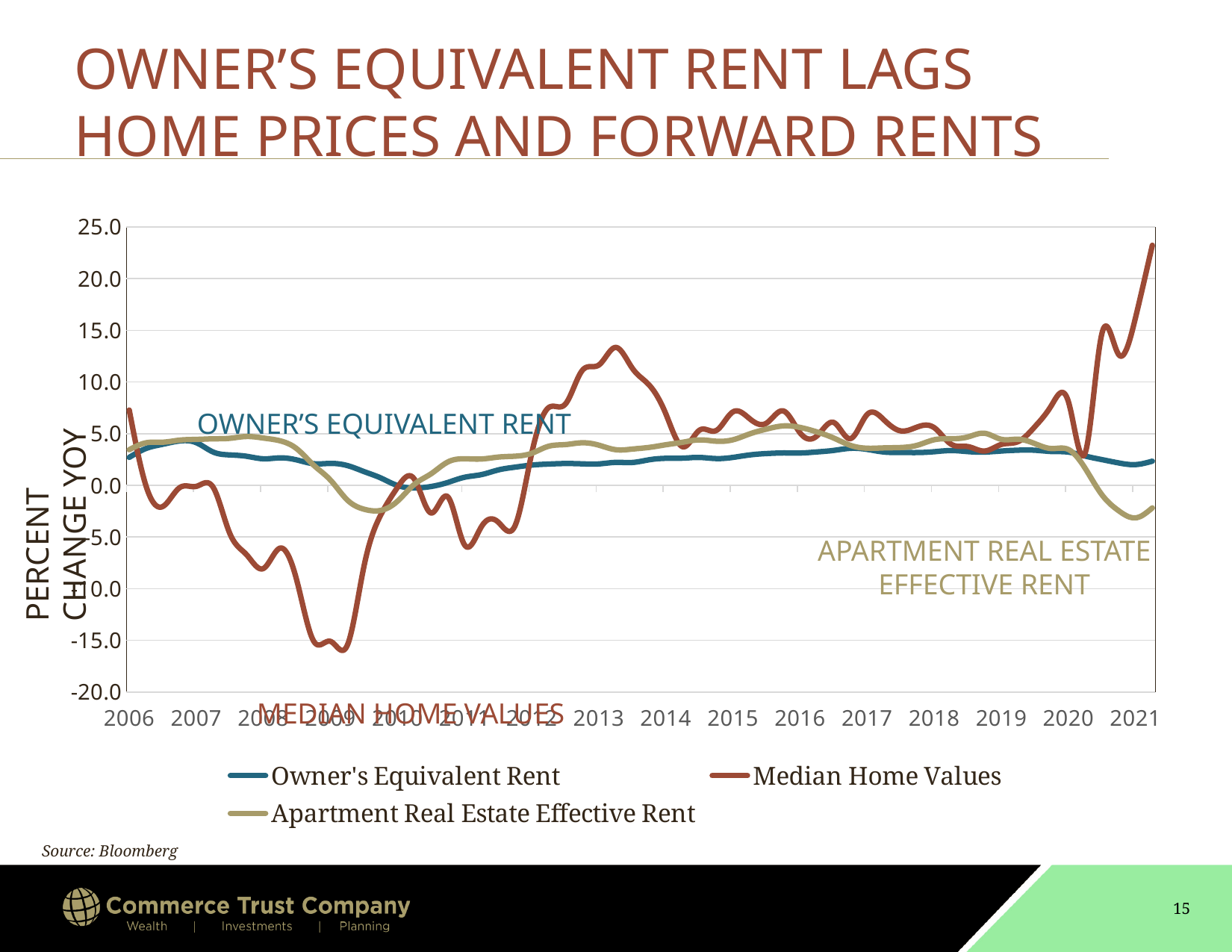
Does the Median Home Values line rise or fall from 2020 to 2021? Rise What kind of chart is shown on the slide? Line chart In 2009, which is larger: Owner's Equivalent Rent or Median Home Values? Owner's Equivalent Rent What is the label on the y axis of the chart? PERCENT CHANGE YOY Is the lowest value for Median Home Values around 2009 greater or less than -10.0? less How many series does the legend list? 3 Is the value for Apartment Real Estate Effective Rent at the end of 2021 greater or less than 0.0? less Which series reaches the lowest value anywhere on the chart? Median Home Values Which series reaches the highest value anywhere on the chart? Median Home Values How many year labels are shown on the x axis? 16 Is the value for Median Home Values at the end of 2021 greater or less than 20.0? greater At the end of 2021, which is larger: Median Home Values or Owner's Equivalent Rent? Median Home Values